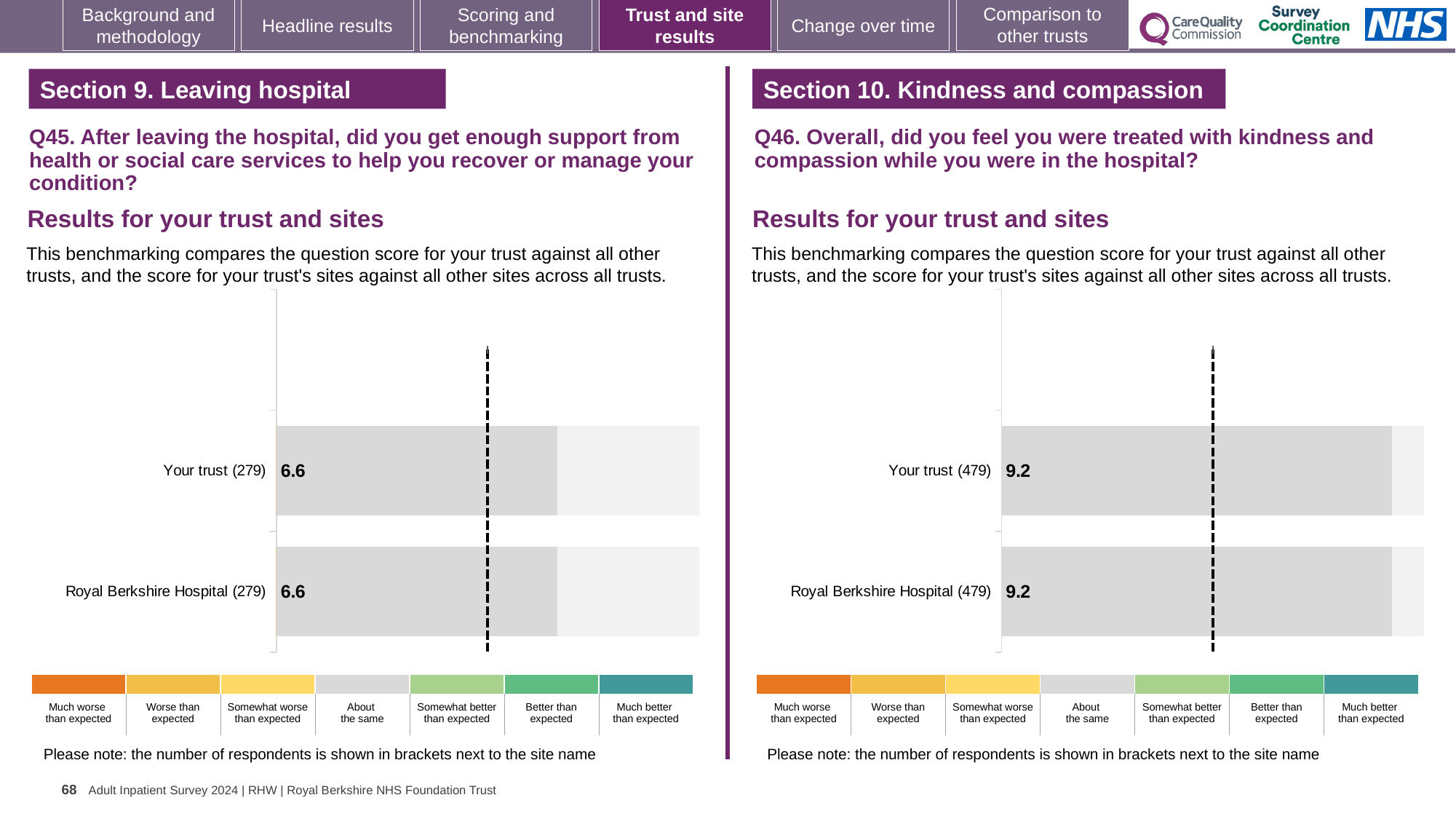
In the Section 9 chart (Q45), what is the difference between the score for Your trust and the score for Royal Berkshire Hospital? 0 How many bars are plotted in the Section 9 chart (Q45)? 2 In the Section 10 chart (Q46), what is the score for Royal Berkshire Hospital? 9.2 How many bars are plotted in the Section 10 chart (Q46)? 2 In the Section 9 chart (Q45), how many respondents are shown in brackets for Your trust? 279 In the Section 10 chart (Q46), what is the score for Your trust? 9.2 In the Section 10 chart (Q46), what is the difference between the score for Your trust and the score for Royal Berkshire Hospital? 0 In the Section 10 chart (Q46), how many respondents are shown in brackets for Royal Berkshire Hospital? 479 In the Section 9 chart (Q45), what is the score for Royal Berkshire Hospital? 6.6 In the Section 9 chart (Q45), what is the score for Your trust? 6.6 What kind of chart is used in the Section 10 chart (Q46)? Bar chart Is the score for Your trust in the Section 10 chart (Q46) larger than the score for Your trust in the Section 9 chart (Q45)? Yes